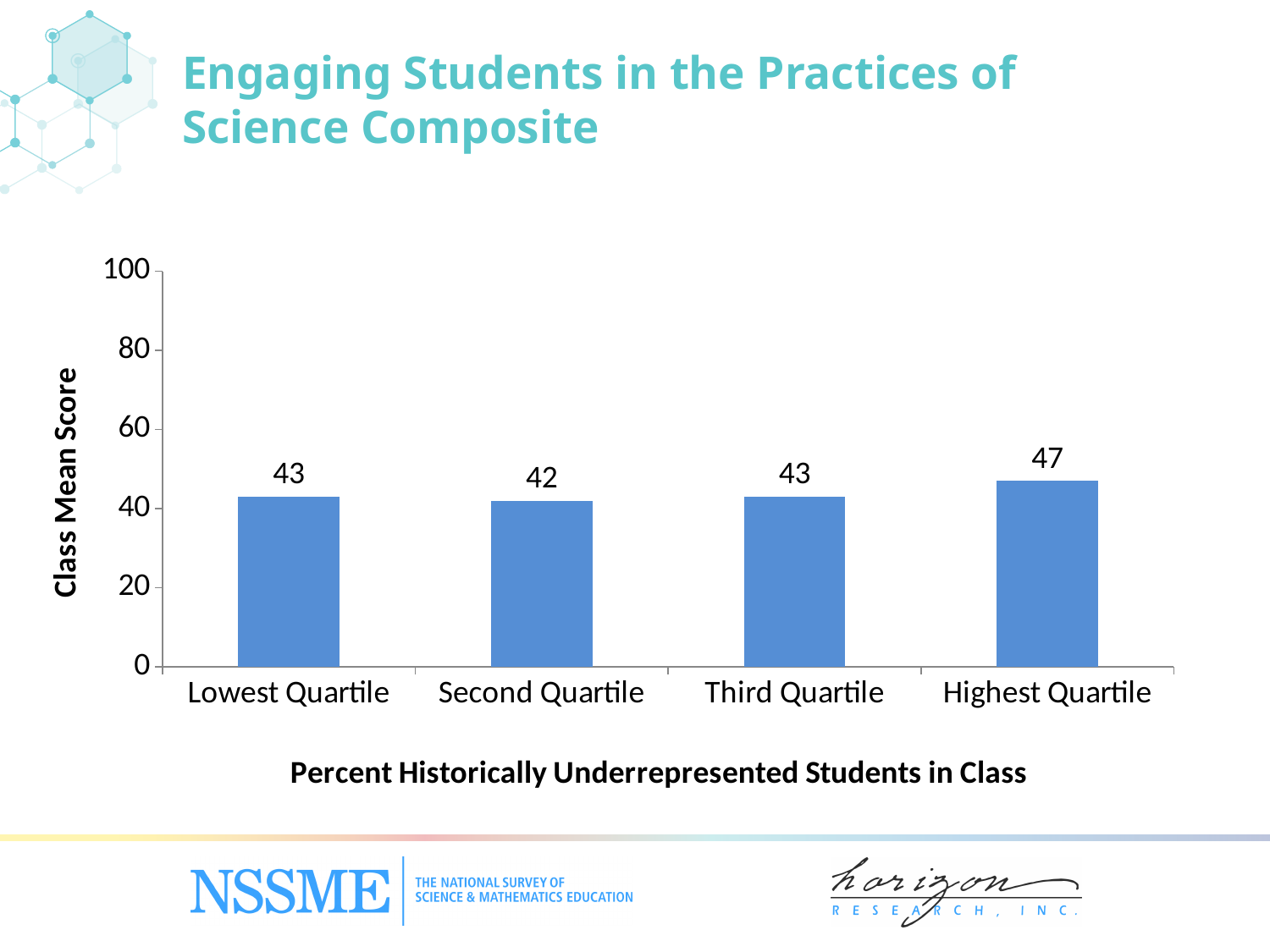
What is the class mean score for the Lowest Quartile? 43 What kind of chart is shown on the slide? Bar chart What is the difference between the class mean scores of the Highest Quartile and the Third Quartile? 4 Is the class mean score for the Third Quartile greater or less than 60? less How many quartile categories are shown on the x axis? 4 What is the label of the x axis? Percent Historically Underrepresented Students in Class What is the class mean score for the Highest Quartile? 47 What is the difference between the class mean scores of the Highest Quartile and the Second Quartile? 5 Which quartile has the lowest class mean score? Second Quartile Which quartile has the highest class mean score? Highest Quartile Which has a larger class mean score, the Highest Quartile or the Lowest Quartile? Highest Quartile What is the class mean score for the Second Quartile? 42